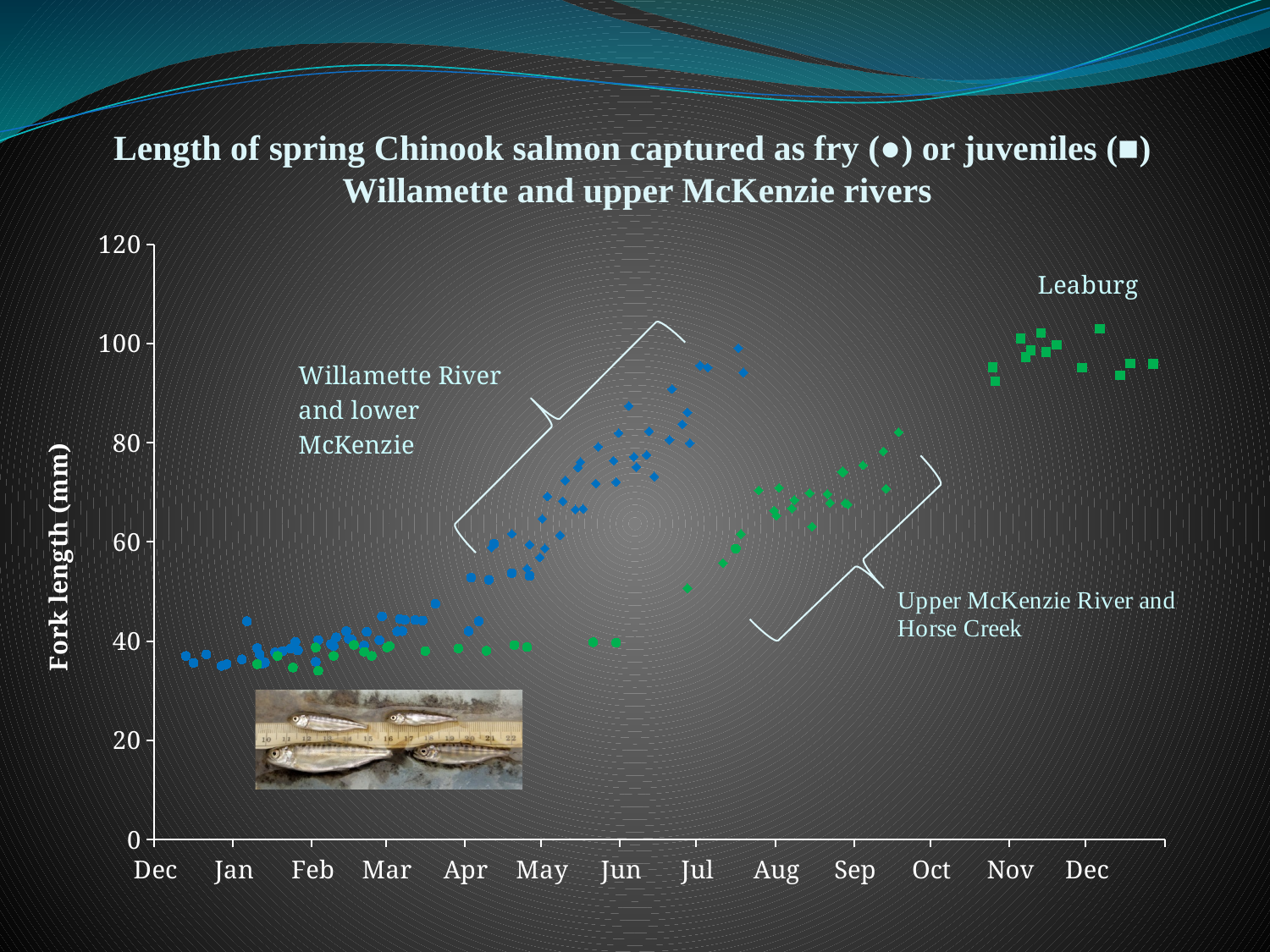
What kind of chart is shown on the slide? scatter chart Are the fork lengths of the Leaburg fish (Nov–Dec) greater or less than 80 mm? greater Which group of points reaches the highest fork lengths on the chart? Leaburg What is the label on the vertical axis of the chart? Fork length (mm) Are the fork lengths of the Willamette River and lower McKenzie fish in July greater or less than 80 mm? greater Do the fork lengths of the Willamette River and lower McKenzie fish rise or fall from December to July? rise Which group has larger fork lengths: the Leaburg fish in November–December or the fry captured in January? Leaburg fish How many month labels are shown along the horizontal axis of the chart? 13 Are the fork lengths of the Upper McKenzie River and Horse Creek fish in August and September greater or less than 40 mm? greater What is the highest value shown on the vertical axis of the chart? 120